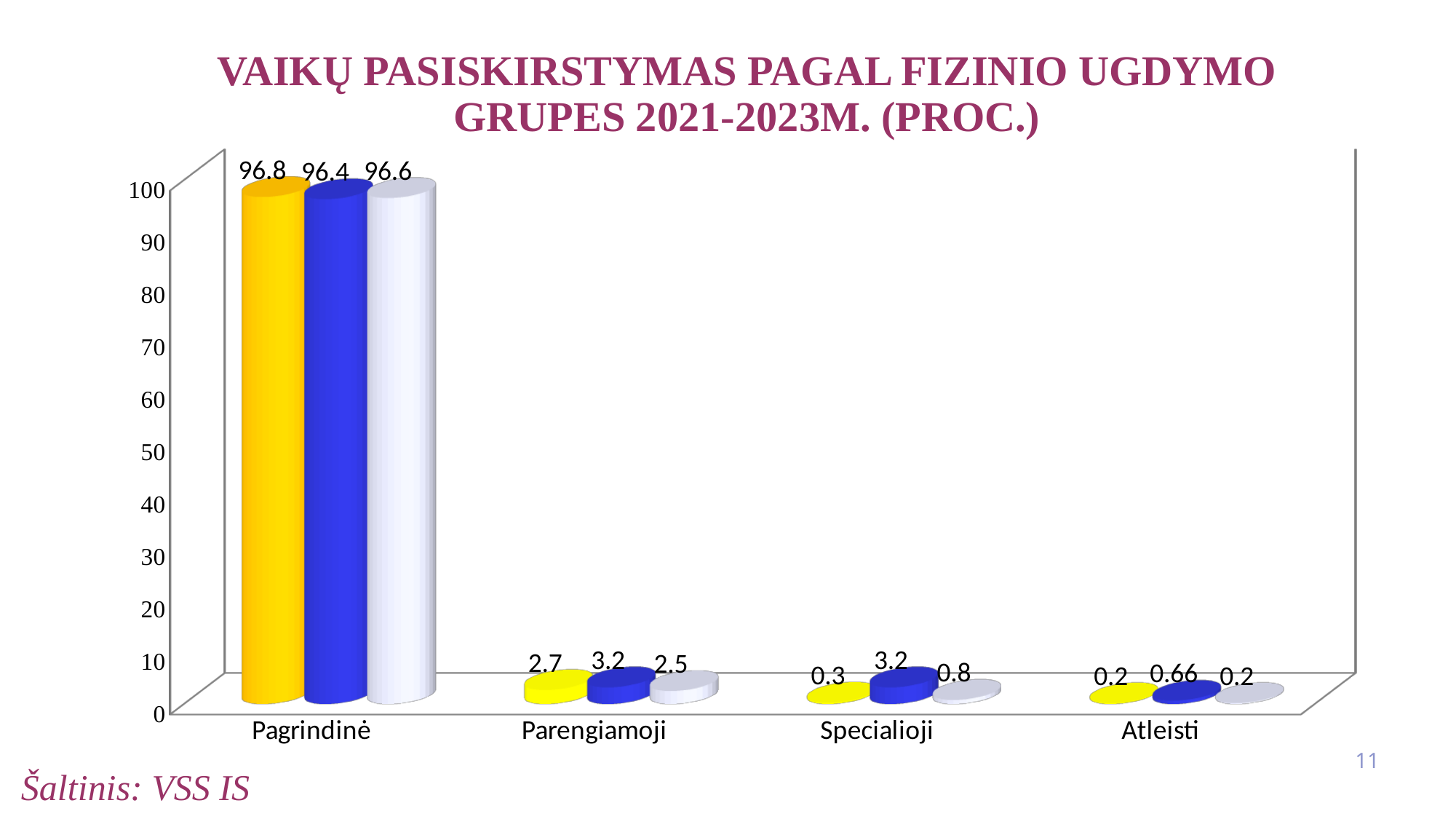
How many categories are shown on the x axis? 4 Which category has the lowest value for the yellow bar? Atleisti Is the value of the white bar for Pagrindinė greater or less than 90? greater What kind of chart is shown on the slide? bar chart Which is larger for Parengiamoji: the yellow bar or the blue bar? the blue bar What is the value of the white bar for Parengiamoji? 2.5 What is the value of the blue bar for Specialioji? 3.2 What is the value of the yellow bar for Pagrindinė? 96.8 What is the difference between the yellow bar and the blue bar for Pagrindinė? 0.4 What is the difference between the blue bar and the yellow bar for Specialioji? 2.9 Which category has the highest values across all three bars? Pagrindinė What is the value of the blue bar for Atleisti? 0.66